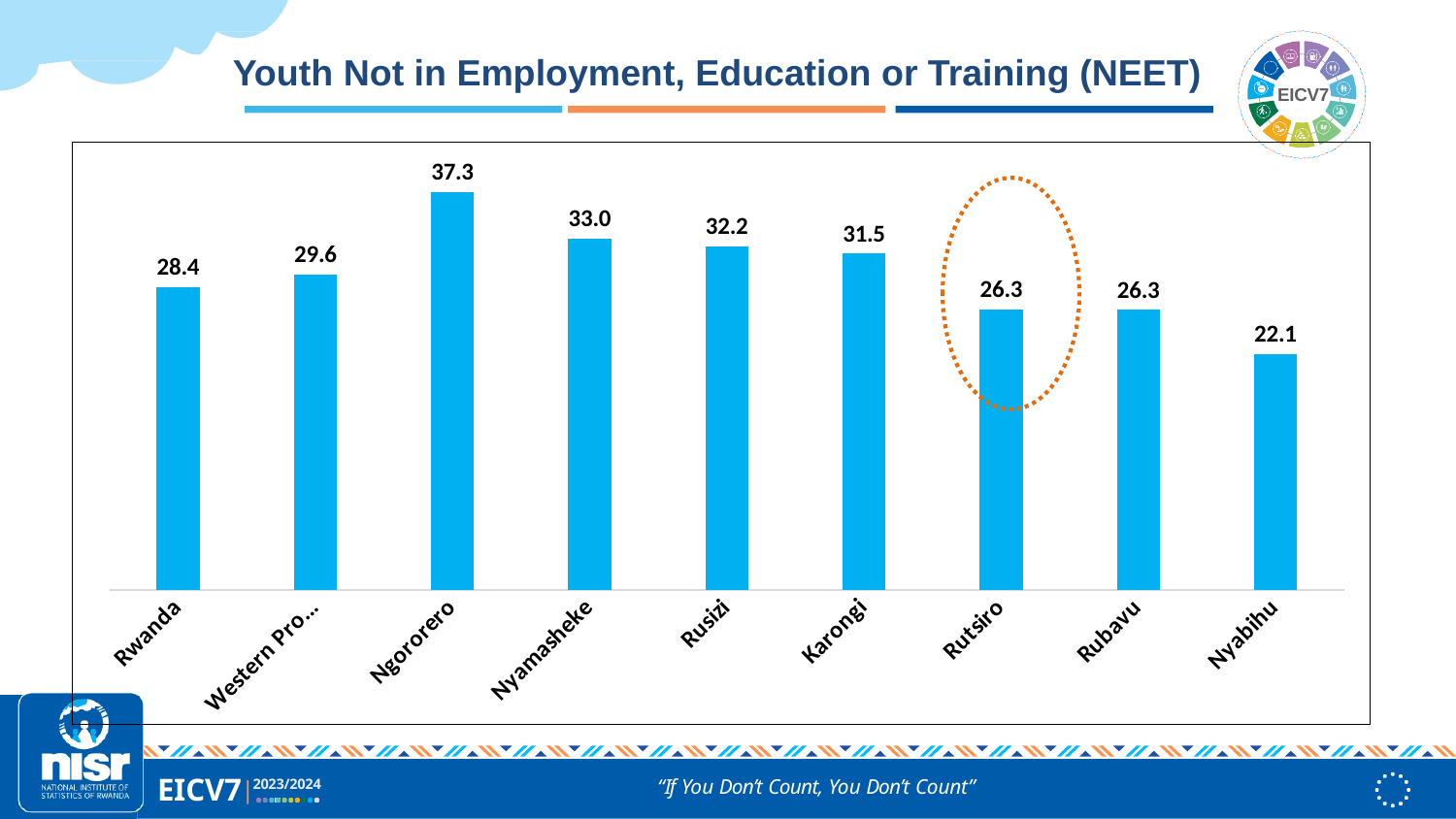
What is the difference between the values for Nyamasheke and Rusizi? 0.8 What is the value for Rwanda? 28.4 What is the value for Karongi? 31.5 Which category has the highest value? Ngororero What is the value for Nyabihu? 22.1 What kind of chart is shown on the slide? Bar chart Which category has the lowest value? Nyabihu What is the value for Ngororero? 37.3 Which category is highlighted with a dotted orange circle? Rutsiro Which is larger, the value for Rusizi or the value for Rubavu? Rusizi How many categories are shown on the chart? 9 What is the difference between the values for Ngororero and Nyabihu? 15.2